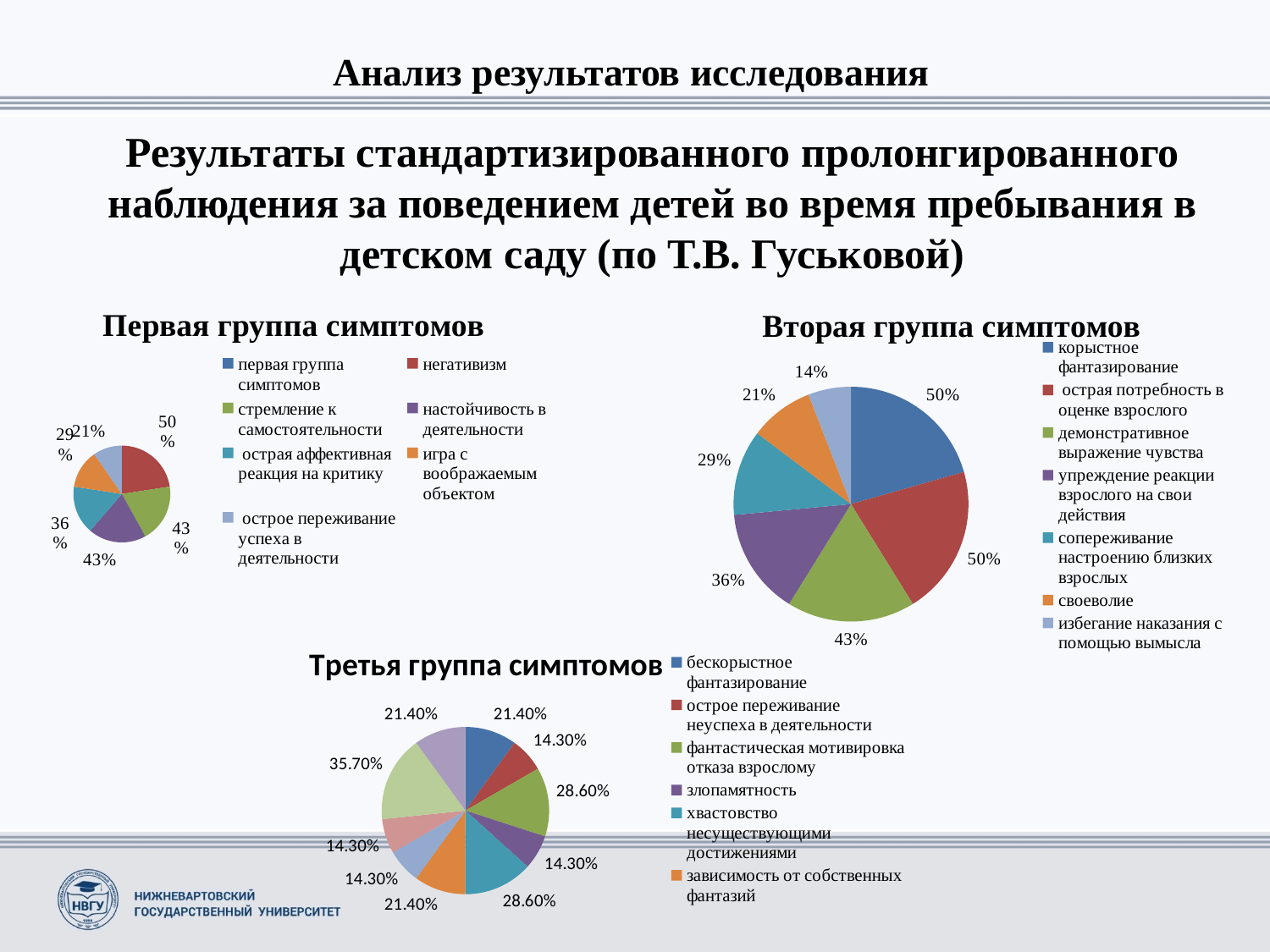
What kind of chart is used for 'Вторая группа симптомов'? pie chart How many slices does the 'Вторая группа симптомов' pie chart have? 7 In the 'Вторая группа симптомов' chart, what is the difference between 'упреждение реакции взрослого на свои действия' and 'сопереживание настроению близких взрослых'? 7 percentage points In the 'Вторая группа симптомов' chart, what is the value for 'избегание наказания с помощью вымысла'? 14% In the 'Вторая группа симптомов' chart, what is the value for 'своеволие'? 21% How many entries does the legend of the 'Первая группа симптомов' chart list? 7 In the 'Третья группа симптомов' chart, what is the value for 'фантастическая мотивировка отказа взрослому'? 28.60% In the 'Вторая группа симптомов' chart, which category has the smallest slice? избегание наказания с помощью вымысла In the 'Третья группа симптомов' chart, what is the value for 'бескорыстное фантазирование'? 21.40% In the 'Вторая группа симптомов' chart, what is the value for 'демонстративное выражение чувства'? 43% In the 'Третья группа симптомов' chart, what is the value for 'злопамятность'? 14.30% In the 'Третья группа симптомов' chart, which is larger: 'хвастовство несуществующими достижениями' or 'зависимость от собственных фантазий'? хвастовство несуществующими достижениями